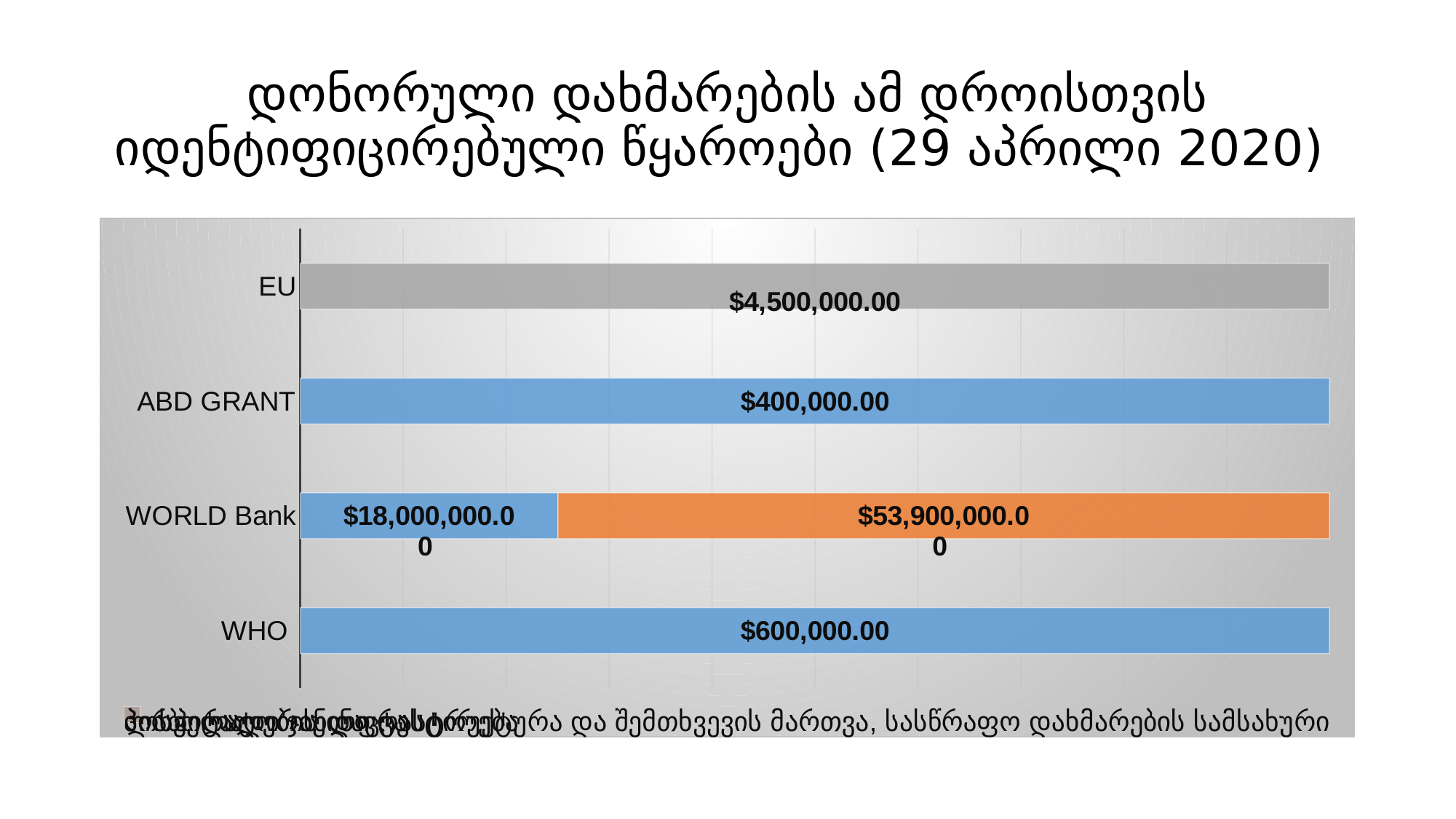
What is the value of the orange segment of the WORLD Bank bar? $53,900,000.00 What is the difference between the values for WHO and ABD GRANT? $200,000.00 Which category has the largest total value according to the data labels? WORLD Bank What kind of chart is shown on the slide? bar chart What is the value shown for ABD GRANT? $400,000.00 What is the value shown for WHO? $600,000.00 What is the value of the blue segment of the WORLD Bank bar? $18,000,000.00 Which is larger, the value for ABD GRANT or the value for WHO? WHO What is the value shown for EU? $4,500,000.00 What is the total of the two segments in the WORLD Bank bar? $71,900,000.00 How many categories are shown on the chart? 4 What is the difference between the orange and blue segments of the WORLD Bank bar? $35,900,000.00